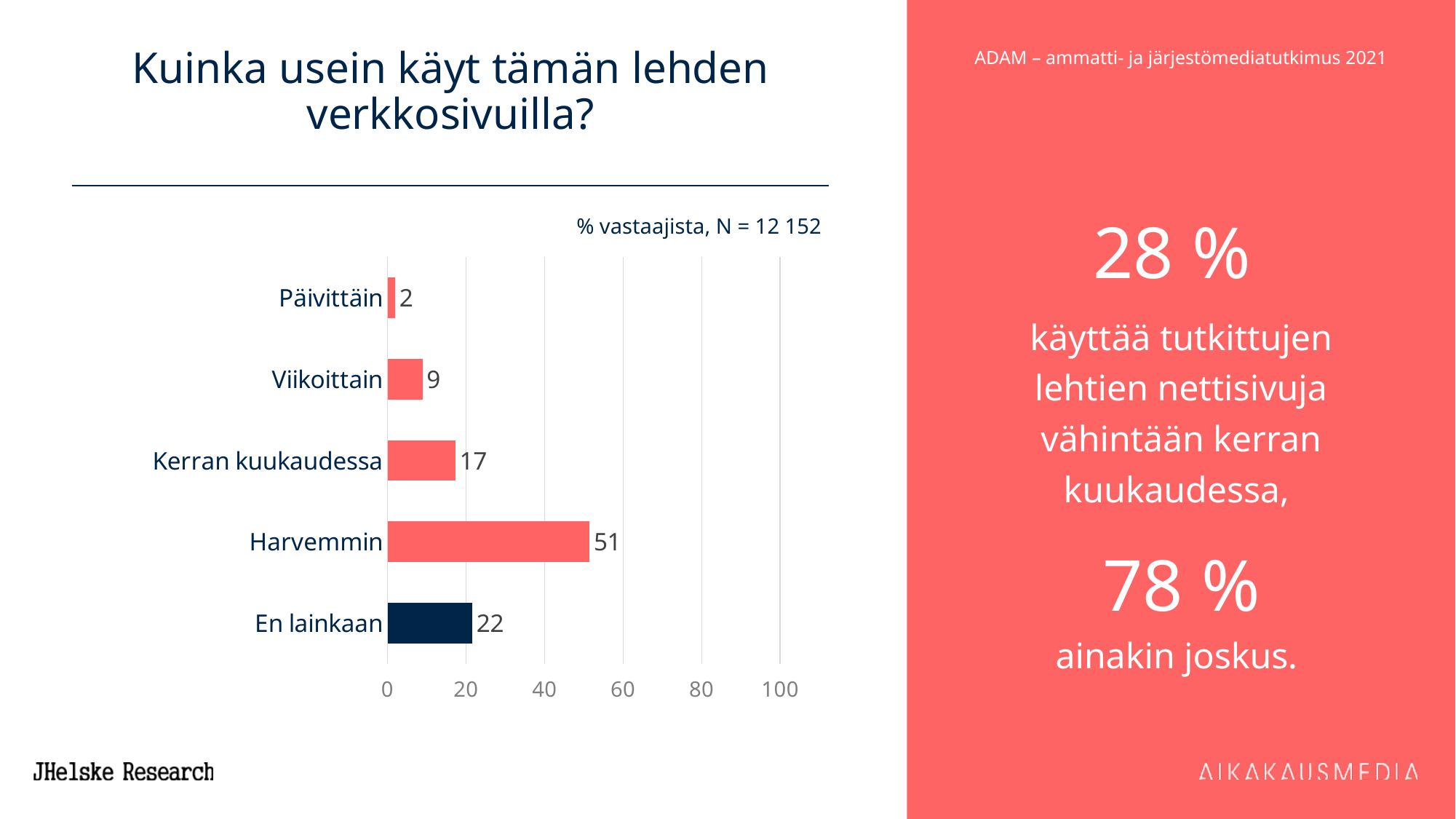
What is the value for Kerran kuukaudessa? 17 Is the value for Harvemmin greater or less than 40? greater What is the value for Päivittäin? 2 Which is larger, the value for Viikoittain or the value for Kerran kuukaudessa? Kerran kuukaudessa What is the difference between the values for Harvemmin and En lainkaan? 29 What kind of chart is shown on the slide? bar chart What is the value for Harvemmin? 51 Which category's bar is coloured dark navy instead of red? En lainkaan How many categories are shown in the chart? 5 Which category has the highest value? Harvemmin What is the value for En lainkaan? 22 Which category has the lowest value? Päivittäin